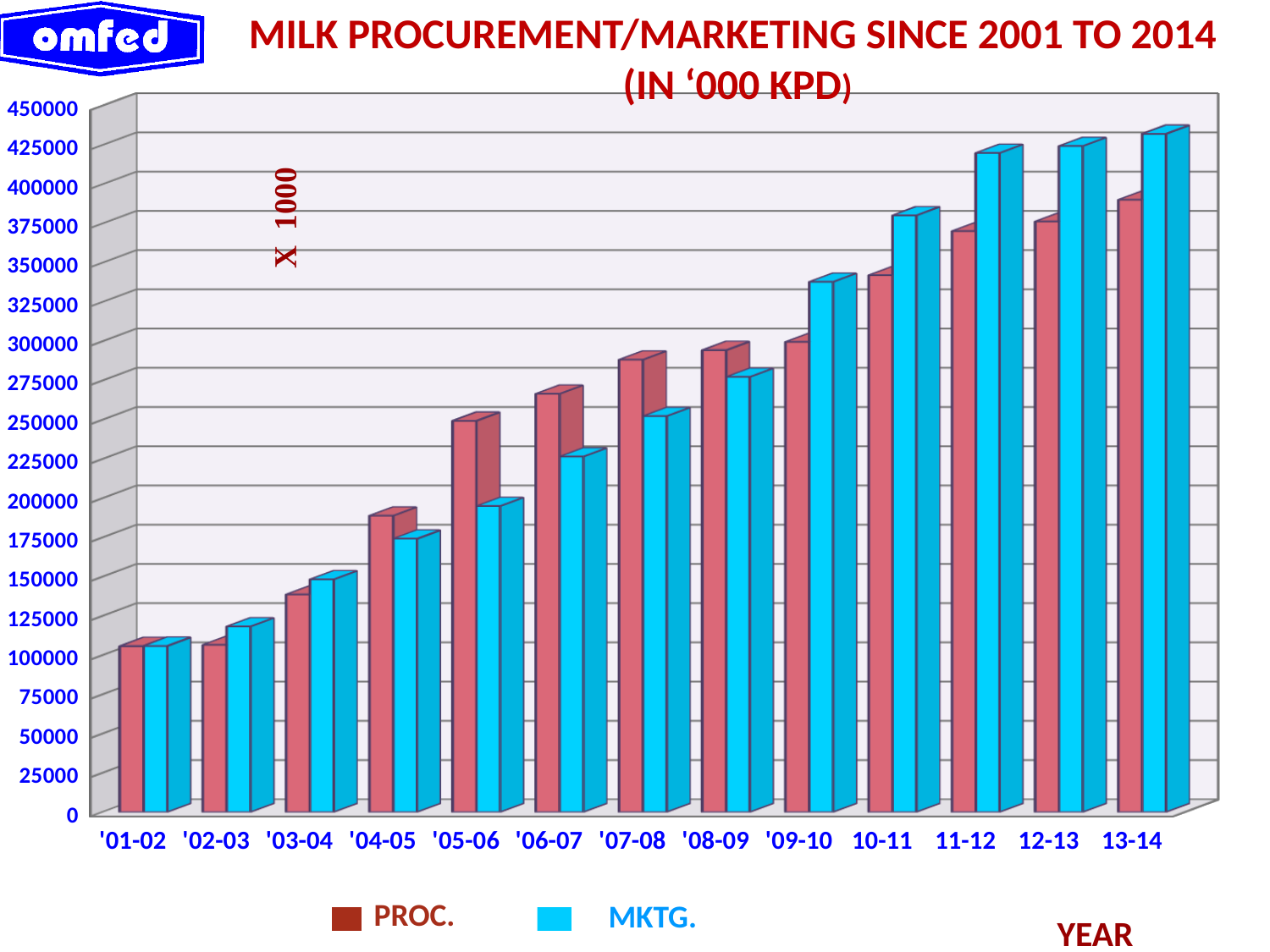
What kind of chart is shown on the slide? Bar chart Is the MKTG. value for 13-14 greater or less than 400000? greater Do the MKTG. values generally rise or fall from '01-02 to 13-14? rise Which year has the lowest MKTG. value? '01-02 In 11-12, which is larger, PROC. or MKTG.? MKTG. Is the PROC. value for 10-11 greater or less than 325000? greater Which year has the highest MKTG. value? 13-14 Is the MKTG. value for '06-07 greater or less than 250000? less In '05-06, which is larger, PROC. or MKTG.? PROC. How many years are shown along the x axis? 13 How many series does the legend list? 2